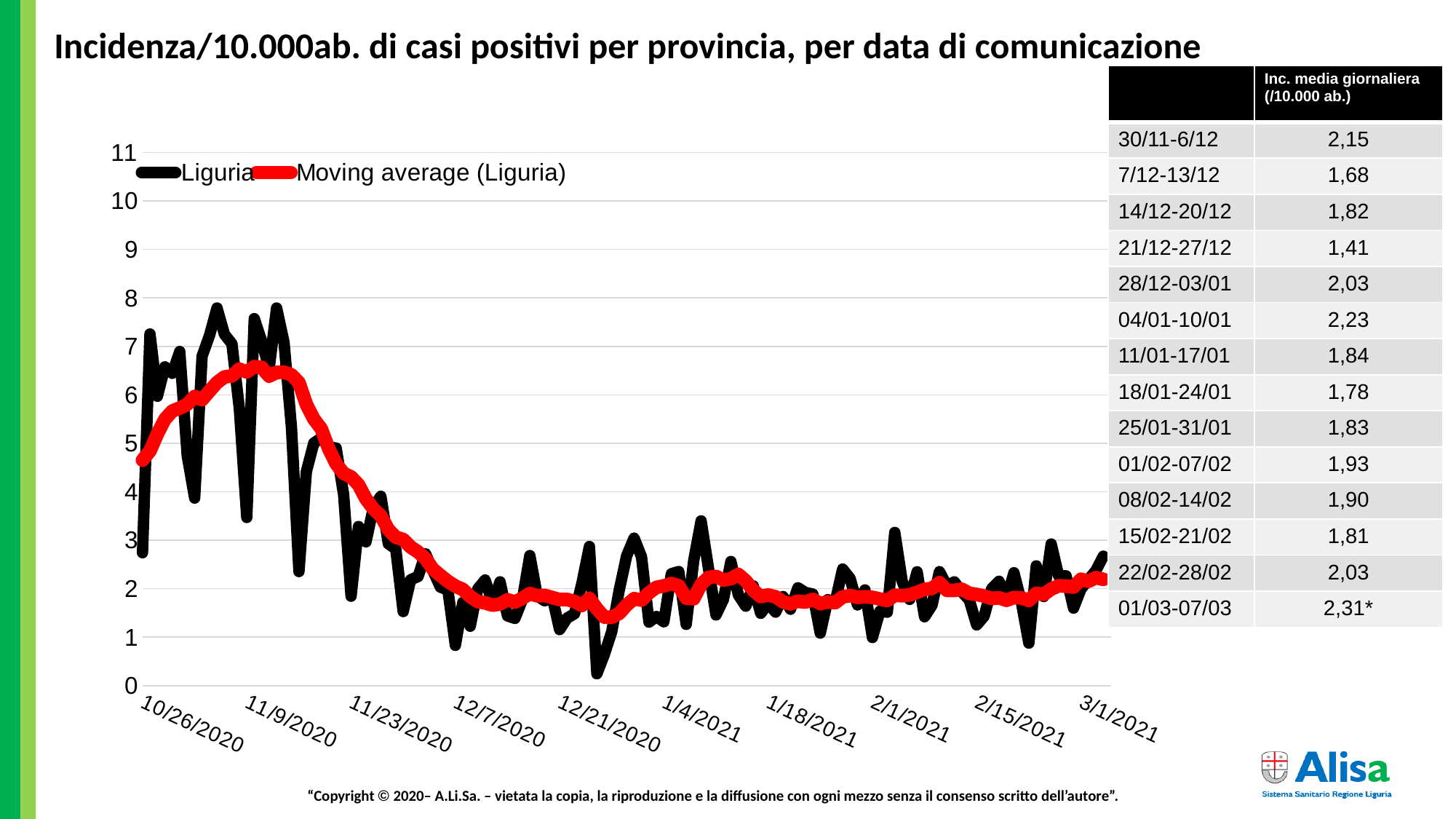
Which series reaches the higher peak value on the chart, Liguria or Moving average (Liguria)? Liguria Is the Moving average (Liguria) value at 11/9/2020 greater or less than 5? greater What are the two series named in the chart legend? Liguria; Moving average (Liguria) Does the Moving average (Liguria) line rise or fall between 10/26/2020 and 11/9/2020? rise Does the Moving average (Liguria) line rise or fall between 11/9/2020 and 12/7/2020? fall What kind of chart is shown on the slide? line chart How many date labels are shown on the chart's x axis? 10 Is the Moving average (Liguria) value at 1/18/2021 greater or less than 4? less Is the Moving average (Liguria) value at 10/26/2020 greater or less than 3? greater How many series does the chart legend list? 2 What is the highest value shown on the chart's y axis? 11